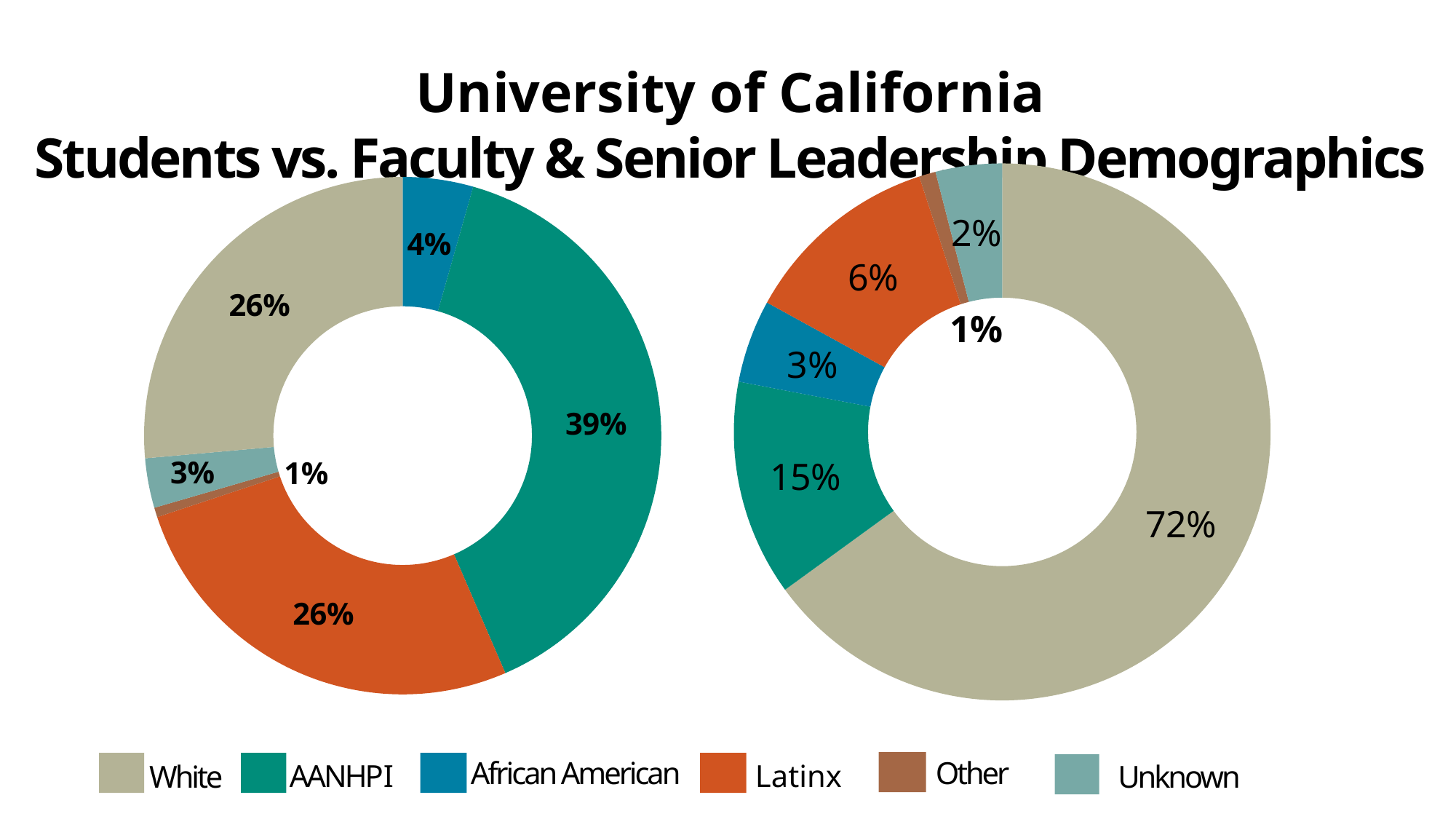
In the right donut chart, which category has the largest share? White In the right donut chart, which is larger: the AANHPI share or the Latinx share? AANHPI What colour represents Latinx in the legend? Orange In the right donut chart, what percentage is shown for White? 72% In the left donut chart, what percentage is shown for African American? 4% In the right donut chart, what percentage is shown for Latinx? 6% What is the difference between the White share in the right donut chart and the White share in the left donut chart? 46% What kind of chart is used on this slide? Donut (pie) chart How many categories does the legend list? 6 In the left donut chart, which category has the largest share? AANHPI In the left donut chart, what percentage is shown for AANHPI? 39% In the left donut chart, which category has the smallest share? Other